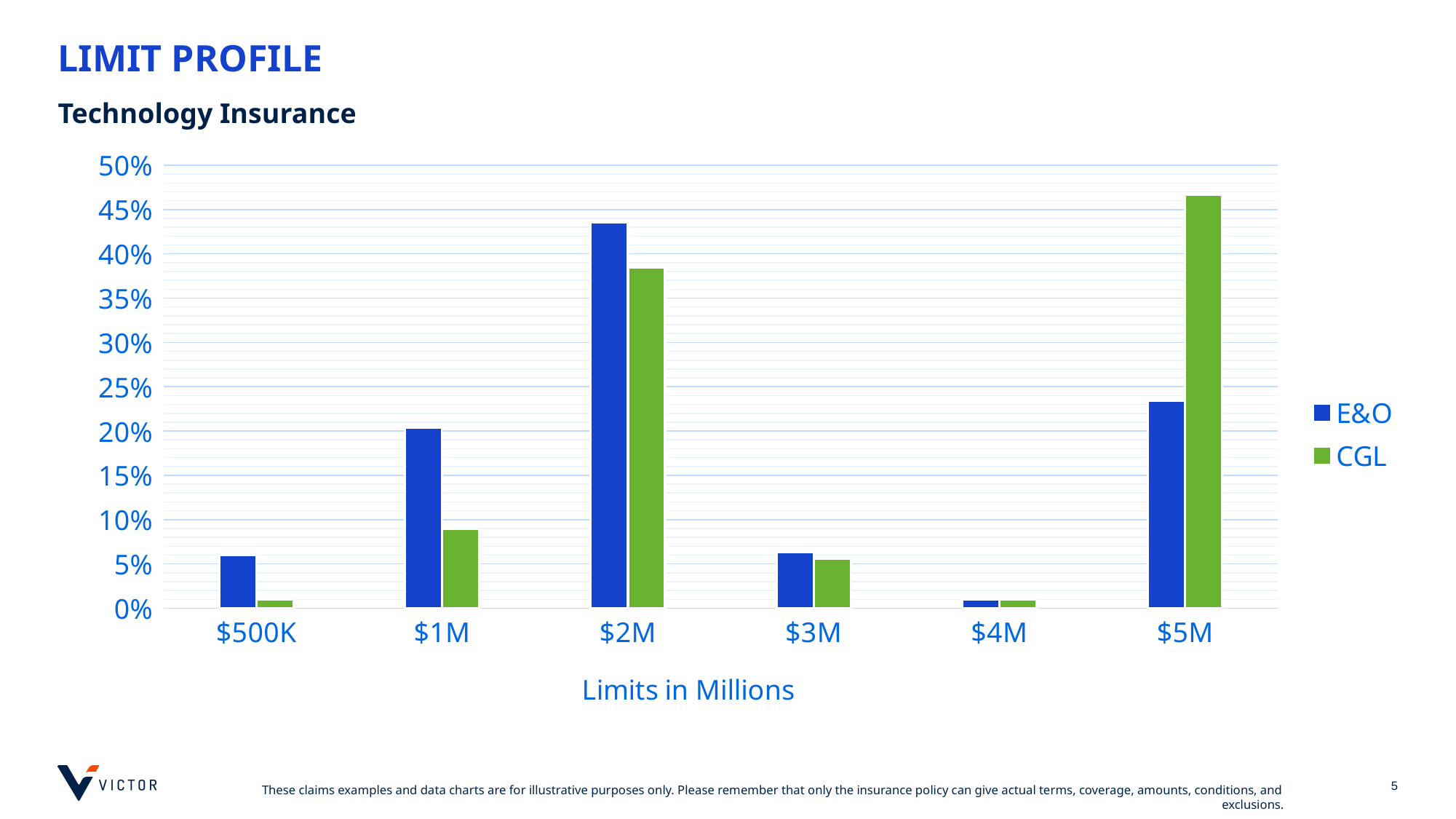
Which limit has the highest E&O value? $2M Which limit has the highest CGL value? $5M Which limit has the lowest E&O value? $4M What kind of chart is shown on the slide? bar chart Is the E&O value for $2M greater or less than 40%? greater How many series does the legend list? 2 How many limit categories are shown on the x axis? 6 Is the CGL value for $1M greater or less than 10%? less At the $2M limit, which series has the larger value, E&O or CGL? E&O At the $5M limit, which series has the larger value, E&O or CGL? CGL What is the title of the x axis? Limits in Millions Is the E&O value for $5M greater or less than 25%? less